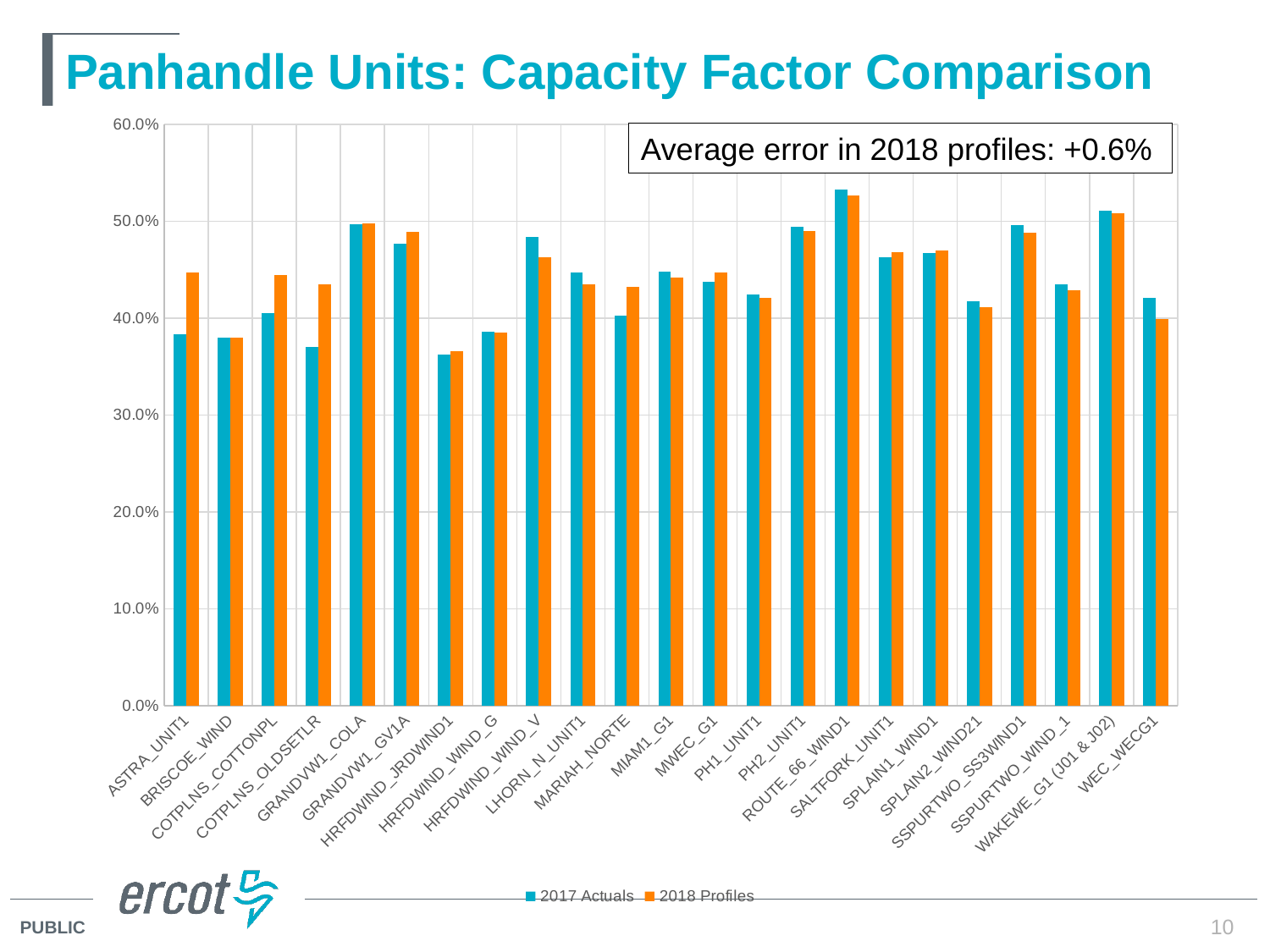
Which unit has the highest 2018 Profiles capacity factor? ROUTE_66_WIND1 Is the 2018 Profiles value for COTPLNS_OLDSETLR greater or less than 40.0%? greater What average error in 2018 profiles is stated in the text box on the chart? +0.6% For WEC_WECG1, which is larger: the 2017 Actuals value or the 2018 Profiles value? 2017 Actuals For ASTRA_UNIT1, which is larger: the 2017 Actuals value or the 2018 Profiles value? 2018 Profiles Which unit has the lowest 2017 Actuals capacity factor? HRFDWIND_JRDWIND1 What kind of chart is shown on the slide? bar chart How many units (categories) are shown on the x axis? 23 How many series does the legend list? 2 Is the 2017 Actuals value for ROUTE_66_WIND1 greater or less than 50.0%? greater Is the 2017 Actuals value for ASTRA_UNIT1 greater or less than 40.0%? less Which unit has the highest 2017 Actuals capacity factor? ROUTE_66_WIND1